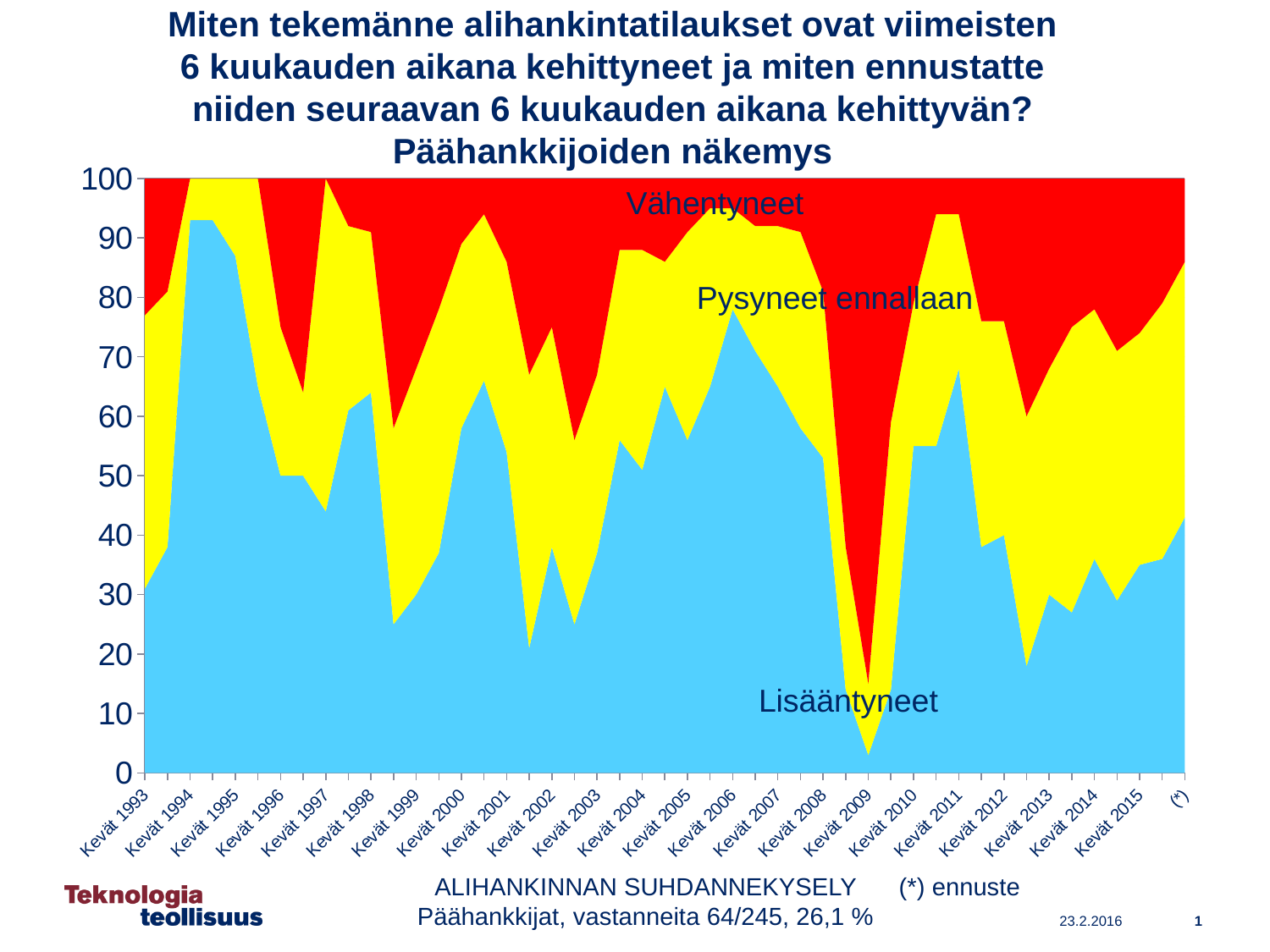
Is the value for Lisääntyneet at Kevät 2002 greater or less than 30? greater What kind of chart is shown on the slide? Stacked area chart At which labelled point is the Lisääntyneet share lowest? Kevät 2009 Which series is drawn at the bottom of the stacked area chart? Lisääntyneet Is the value for Lisääntyneet at Kevät 1994 greater or less than 90? greater What colour is the Vähentyneet area? Red How many series are labelled in the chart? 3 Is the value for Lisääntyneet at Kevät 2006 greater or less than 70? greater Does the Lisääntyneet share rise or fall from Kevät 2008 to Kevät 2009? Fall Which is larger, the Lisääntyneet share at Kevät 2006 or at Kevät 2013? Kevät 2006 At which labelled point is the Lisääntyneet share highest? Kevät 1994